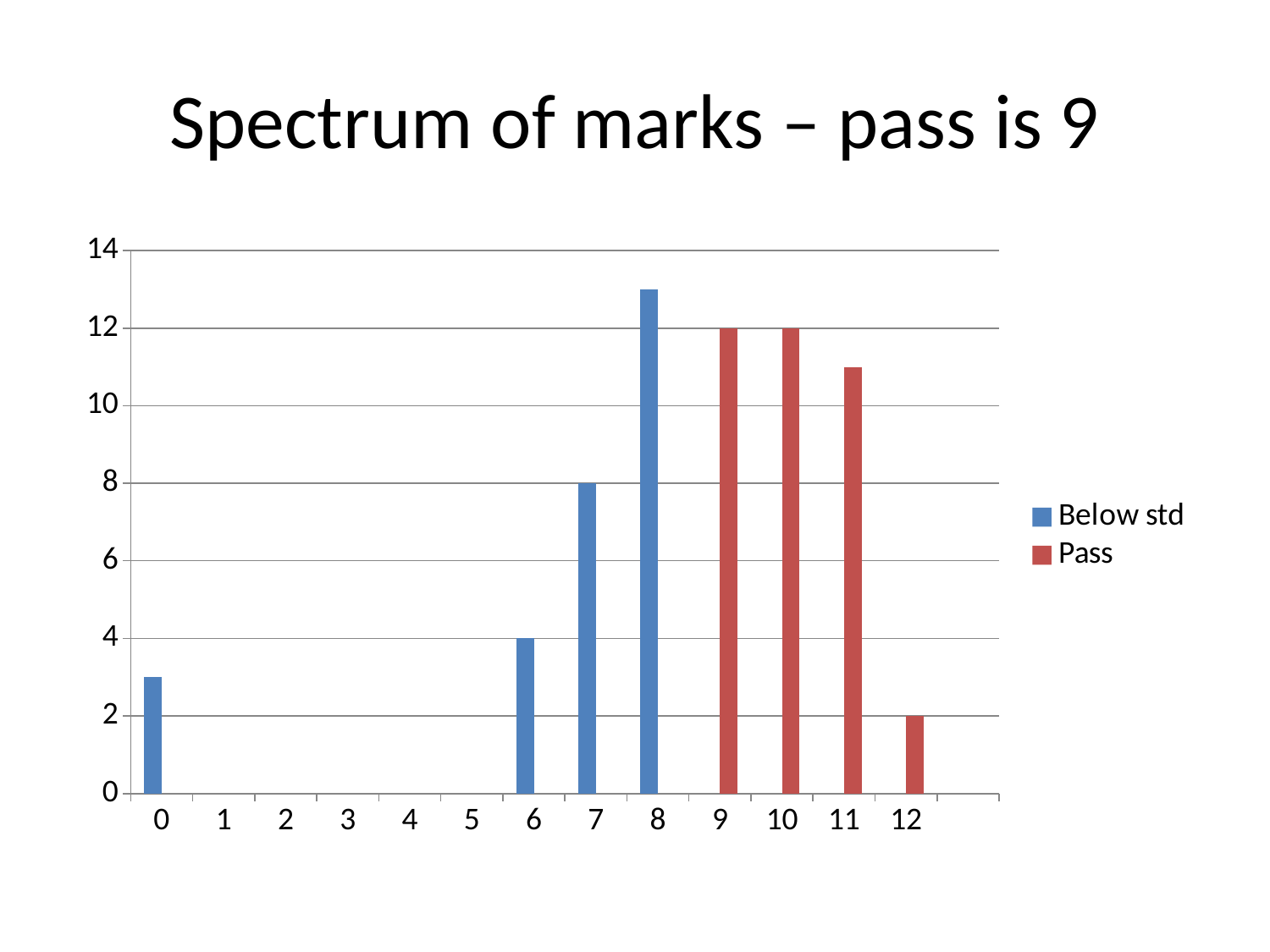
What is the value for mark 6? 4 What is the value for mark 12? 2 Is the value for mark 0 greater or less than 4? less What is the value for mark 9? 12 Which mark has the highest bar? 8 What is the difference between the values for mark 9 and mark 12? 10 Which has the larger value, mark 6 or mark 7? 7 What is the title of the slide? Spectrum of marks – pass is 9 Is the value for mark 11 greater or less than 12? less What kind of chart is shown on the slide? bar chart How many series does the legend list? 2 What is the value for mark 7? 8